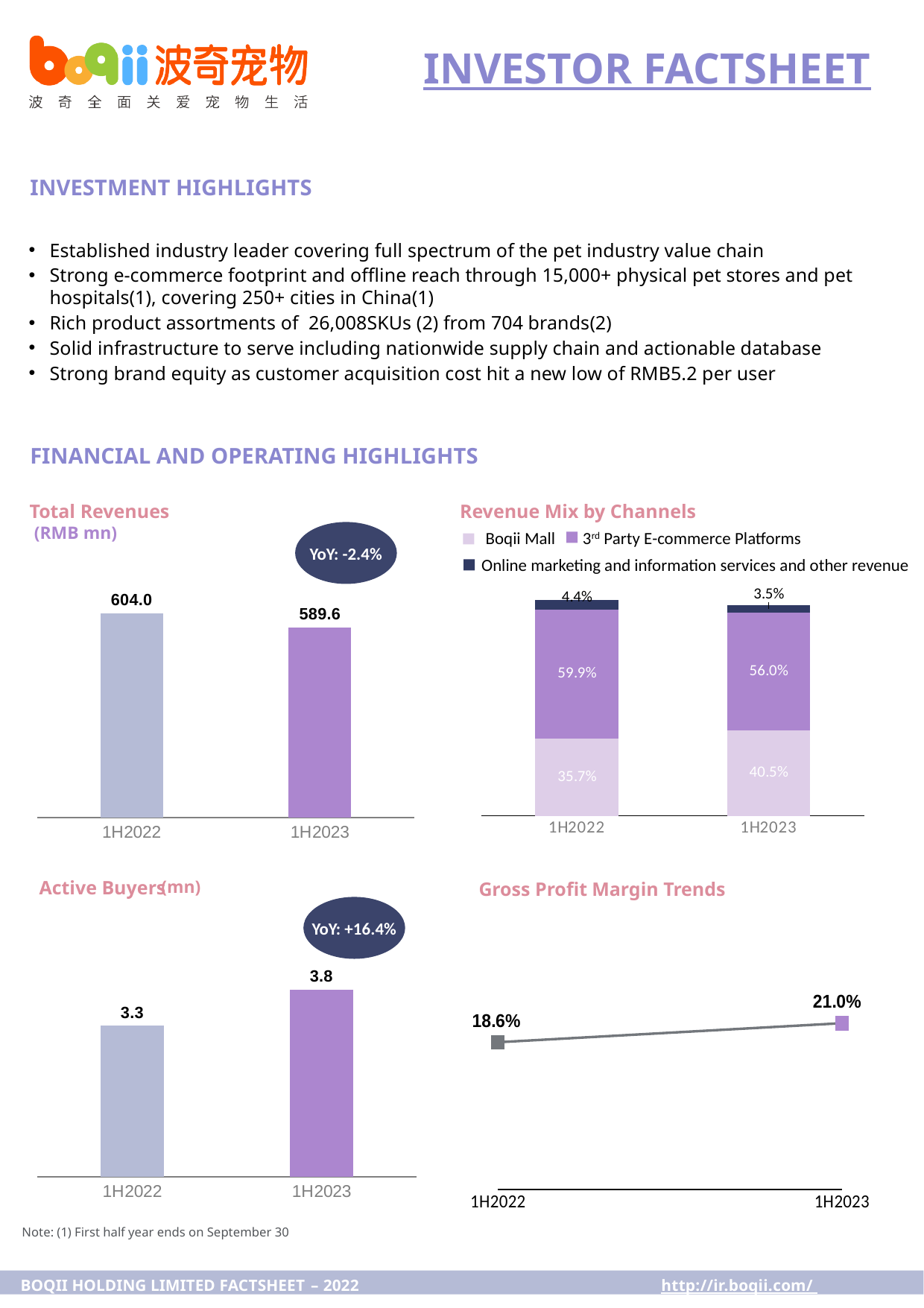
In the Total Revenues chart, what is the value for 1H2022? 604.0 In the Revenue Mix by Channels chart, which channel has the largest share in 1H2023? 3rd Party E-commerce Platforms What kind of chart is the Total Revenues chart? Bar chart How many series does the legend of the Revenue Mix by Channels chart list? 3 In the Revenue Mix by Channels chart, what is the share of Boqii Mall in 1H2023? 40.5% In the Total Revenues chart, what is the value for 1H2023? 589.6 In the Gross Profit Margin Trends chart, what is the value for 1H2022? 18.6% In the Gross Profit Margin Trends chart, which period has the higher gross profit margin, 1H2022 or 1H2023? 1H2023 In the Active Buyers chart, what is the value for 1H2023? 3.8 In the Total Revenues chart, what is the difference between the 1H2022 and 1H2023 values? 14.4 In the Active Buyers chart, do the values rise or fall from 1H2022 to 1H2023? Rise In the Revenue Mix by Channels chart, what is the share of 3rd Party E-commerce Platforms in 1H2022? 59.9%